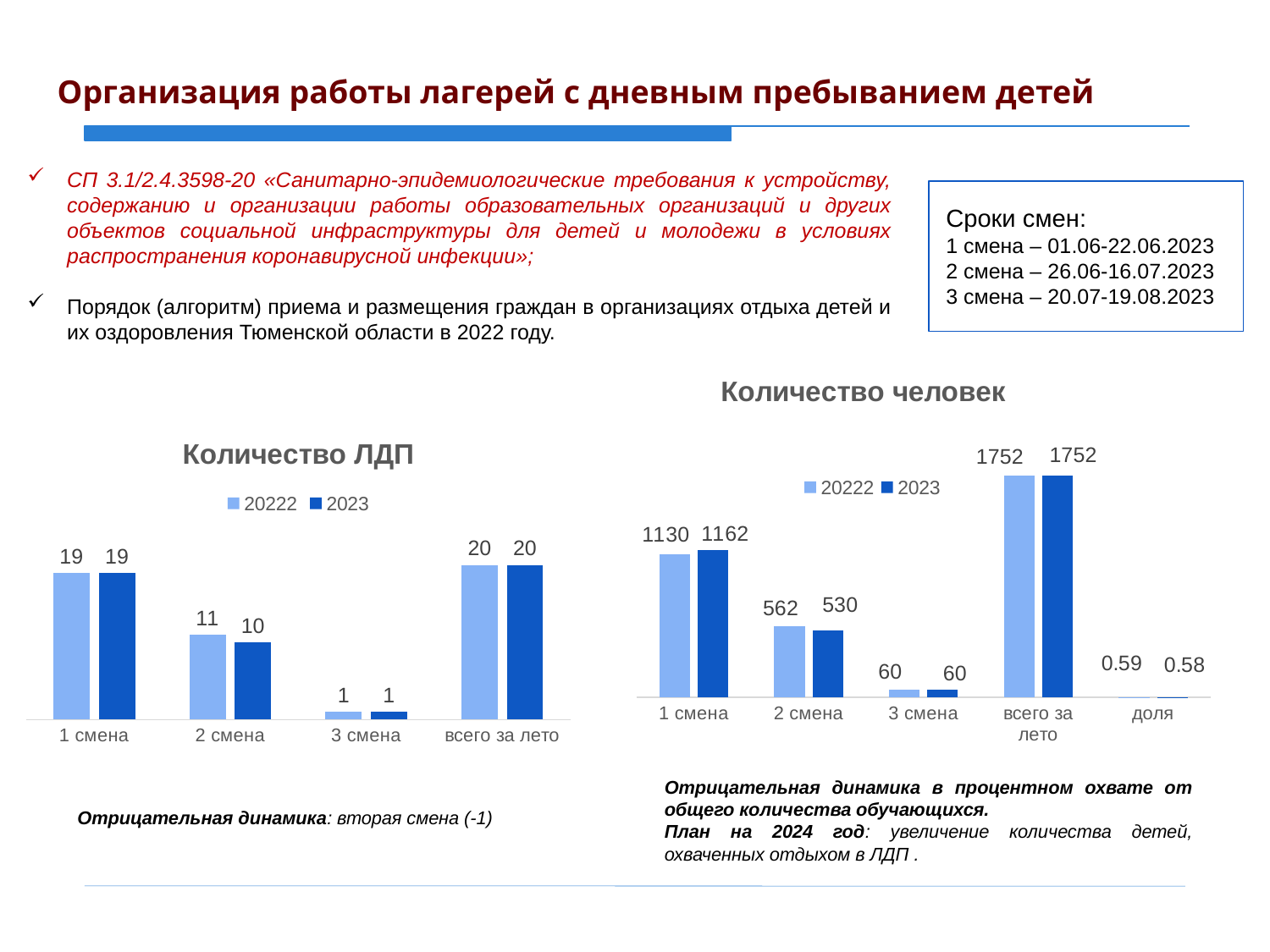
In the chart titled «Количество человек», what is the difference between the «20222» and 2023 values for «2 смена»? 32 In the chart titled «Количество человек», which is larger for «1 смена»: the «20222» value or the 2023 value? 2023 In the chart titled «Количество ЛДП», which category has the lowest values? 3 смена In the chart titled «Количество ЛДП», how many categories are shown on the x axis? 4 In the chart titled «Количество человек», what is the value for «2 смена» in the «20222» series? 562 In the chart titled «Количество человек», what is the value for «доля» in the 2023 series? 0.58 In the chart titled «Количество ЛДП», what is the value for «2 смена» in the 2023 series? 10 In the chart titled «Количество ЛДП», what is the value for «всего за лето» in the «20222» series? 20 In the chart titled «Количество ЛДП», what is the difference between the «20222» and 2023 values for «2 смена»? 1 How many series does the legend of the chart titled «Количество человек» list? 2 What type of chart is the chart titled «Количество ЛДП»? Bar chart In the chart titled «Количество человек», what is the value for «1 смена» in the 2023 series? 1162